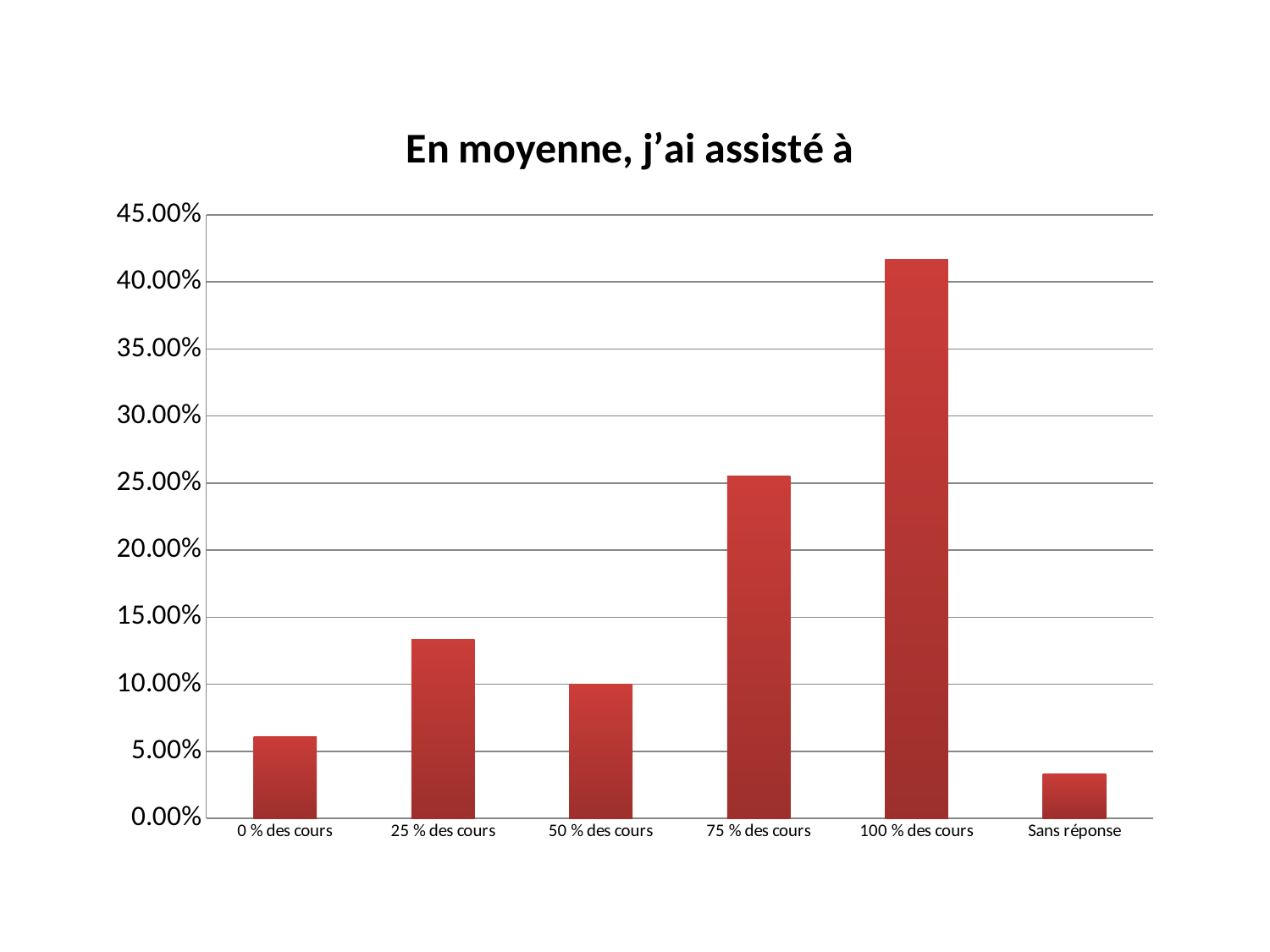
Which category has the lowest value? Sans réponse Is the value for Sans réponse greater or less than 5.00%? less Which is larger, the value for 25 % des cours or the value for 50 % des cours? 25 % des cours Is the value for 100 % des cours greater or less than 40.00%? greater What kind of chart is shown on the slide? bar chart Is the value for 0 % des cours greater or less than 5.00%? greater How many categories are shown on the x axis? 6 What is the title of the chart? En moyenne, j'ai assisté à Which category has the highest value? 100 % des cours Which is larger, the value for 75 % des cours or the value for 100 % des cours? 100 % des cours